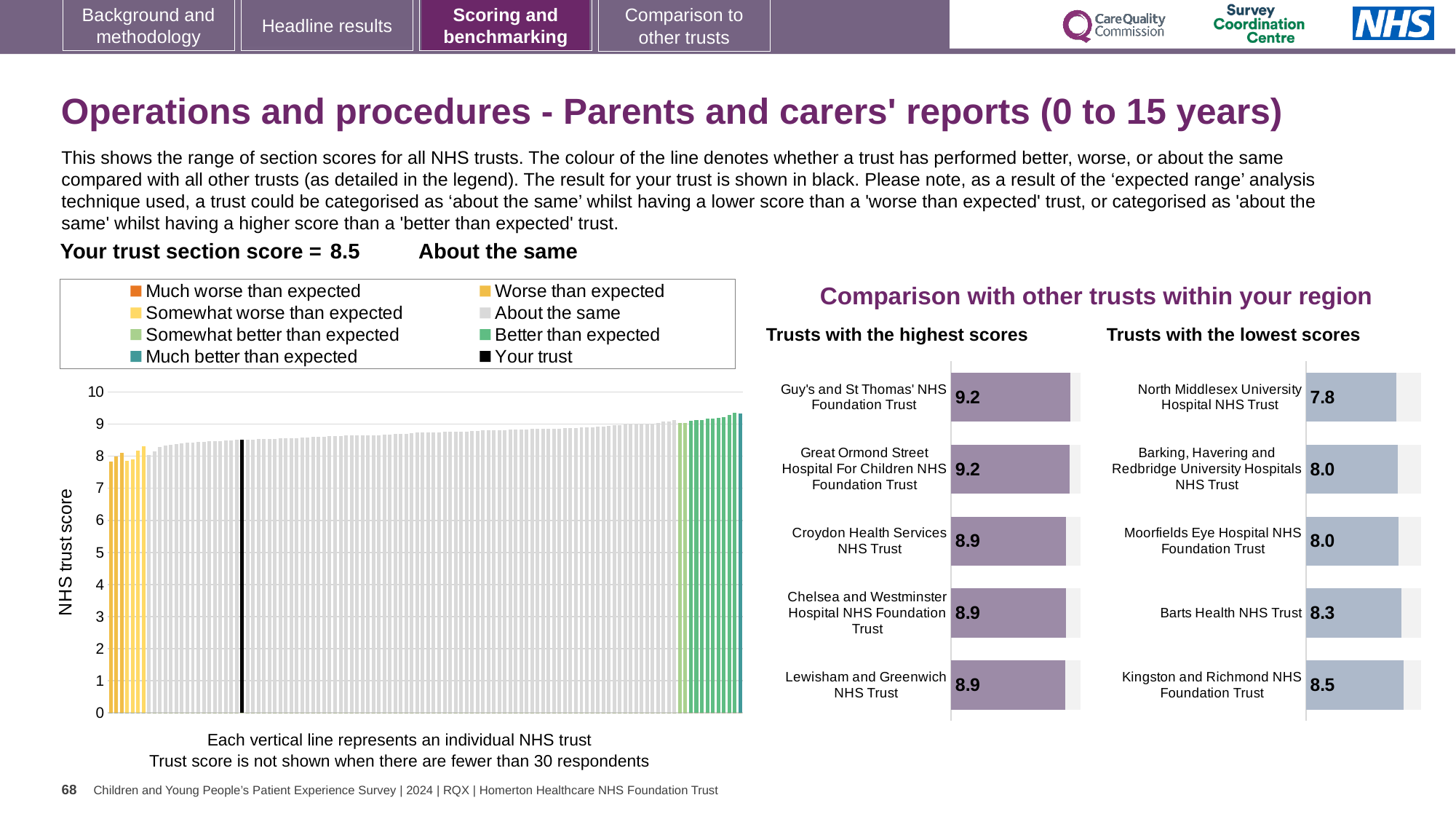
What kind of chart is the large chart on the left showing NHS trust scores? Bar chart In the 'Trusts with the lowest scores' chart, what is the score for North Middlesex University Hospital NHS Trust? 7.8 In the 'Trusts with the lowest scores' chart, what is the difference between the score for Kingston and Richmond NHS Foundation Trust and the score for North Middlesex University Hospital NHS Trust? 0.7 In the 'Trusts with the lowest scores' chart, which trust has the lowest score? North Middlesex University Hospital NHS Trust What is the y-axis label of the large chart on the left? NHS trust score In the 'Trusts with the lowest scores' chart, which trust has the highest score? Kingston and Richmond NHS Foundation Trust How many trusts are listed in the 'Trusts with the highest scores' chart? 5 In the 'Trusts with the highest scores' chart, what is the difference between the score for Guy's and St Thomas' NHS Foundation Trust and the score for Lewisham and Greenwich NHS Trust? 0.3 In the 'Trusts with the lowest scores' chart, which has the larger score: Barts Health NHS Trust or Moorfields Eye Hospital NHS Foundation Trust? Barts Health NHS Trust In the large chart on the left, do the trust scores rise or fall from left to right? Rise How many entries does the legend above the large chart on the left list? 8 In the 'Trusts with the highest scores' chart, what is the score for Croydon Health Services NHS Trust? 8.9